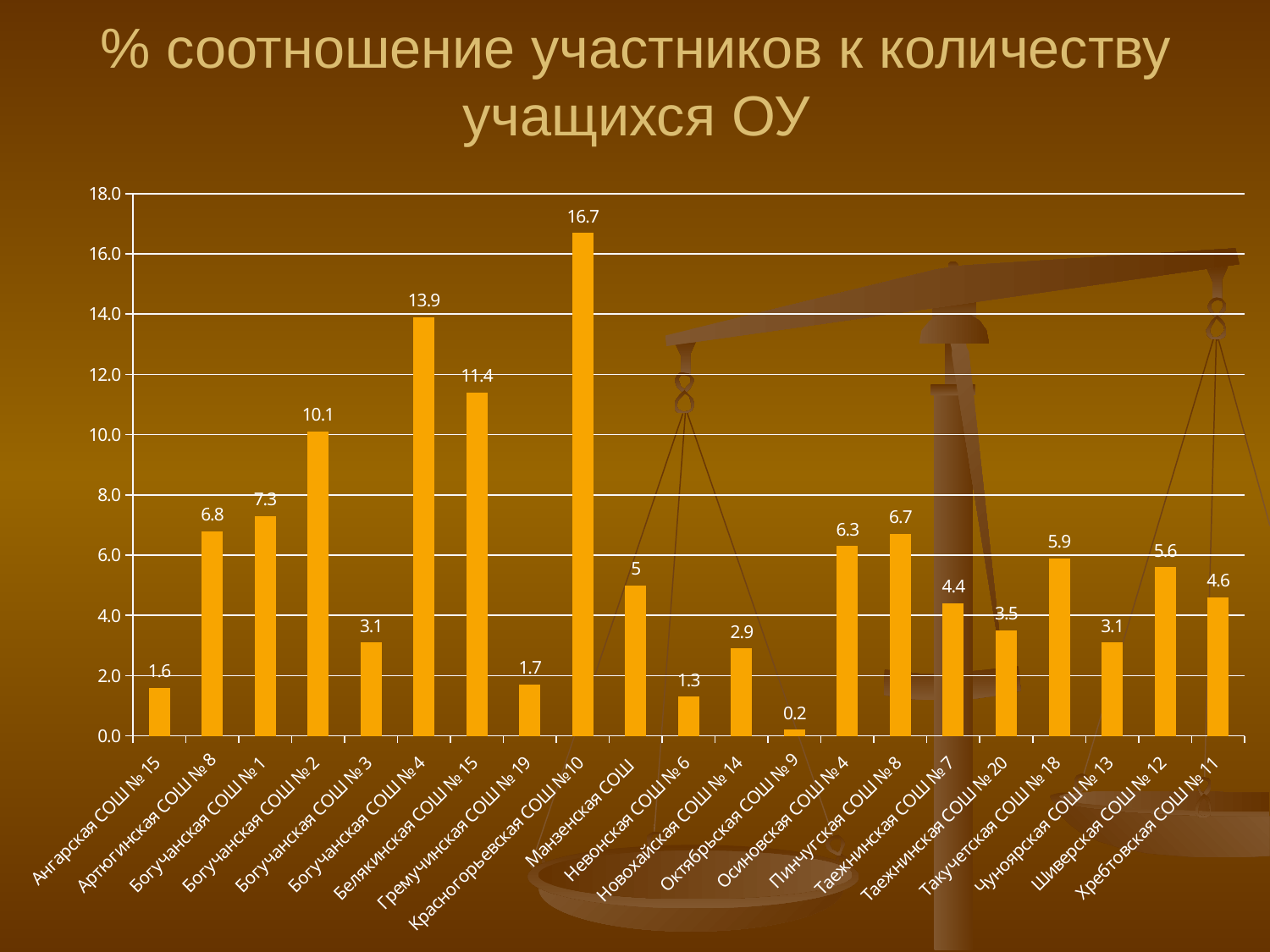
Which is larger, the value for Белякинская СОШ № 15 or the value for Богучанская СОШ № 2? Белякинская СОШ № 15 Is the value for Пинчугская СОШ № 8 greater or less than 6.0? greater What is the difference between the values for Красногорьевская СОШ №10 and Богучанская СОШ № 4? 2.8 What is the title of the chart? % соотношение участников к количеству учащихся ОУ What is the value for Таежнинская СОШ № 7? 4.4 What is the value for Красногорьевская СОШ №10? 16.7 Which school has the highest value? Красногорьевская СОШ №10 How many schools are shown on the x axis? 21 What is the value for Богучанская СОШ № 4? 13.9 What is the value for Манзенская СОШ? 5 What kind of chart is shown on the slide? bar chart Which school has the lowest value? Октябрьская СОШ № 9